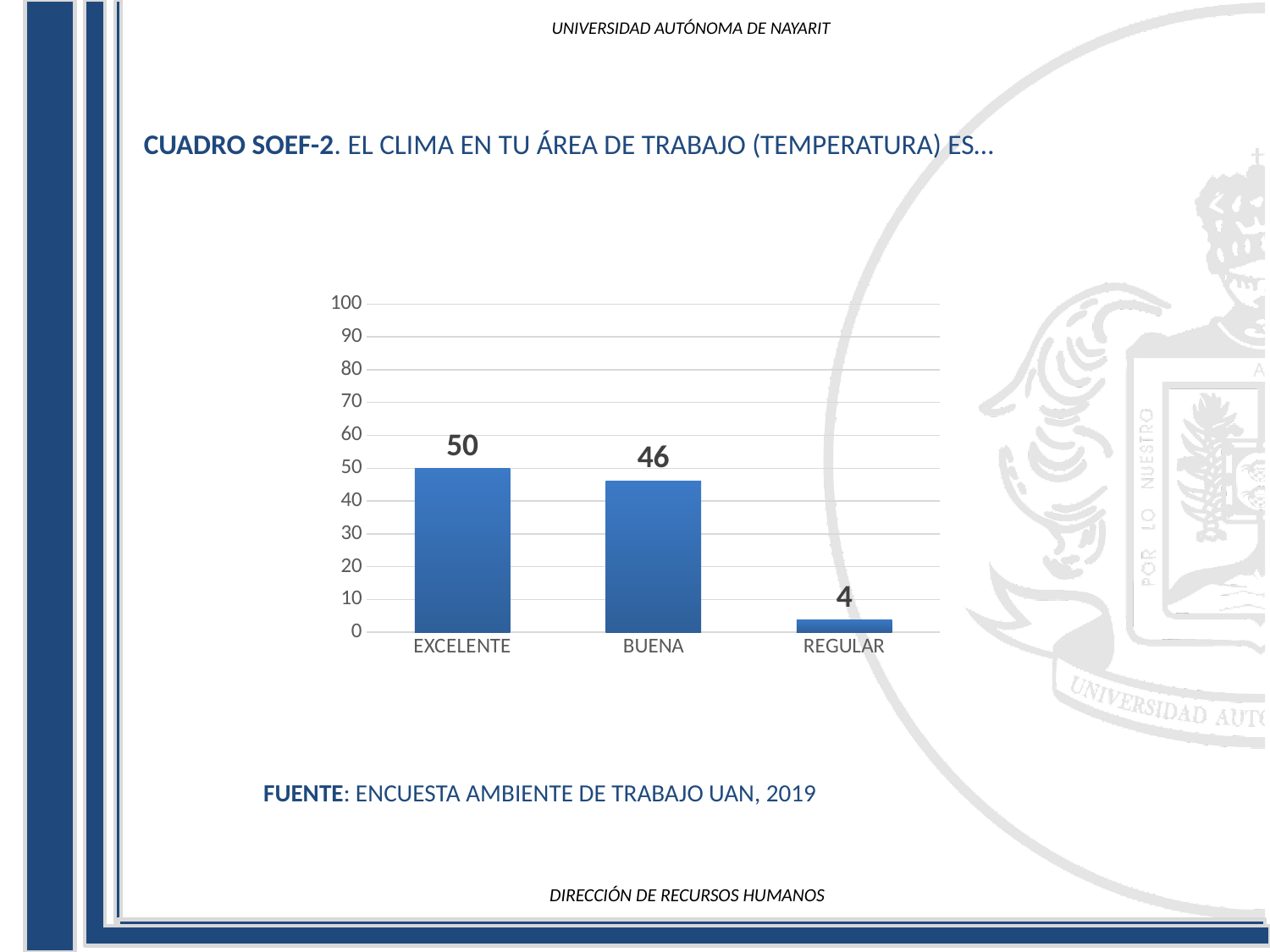
Is the value for EXCELENTE greater or less than 40? greater What is the difference between the values for BUENA and REGULAR? 42 What is the value for BUENA? 46 Which category has the highest value? EXCELENTE What is the difference between the values for EXCELENTE and BUENA? 4 Which category has the lowest value? REGULAR What is the value for REGULAR? 4 What kind of chart is shown on the slide? bar chart How many categories are shown on the x axis? 3 What is the value for EXCELENTE? 50 Which is larger, the value for BUENA or the value for REGULAR? BUENA Do the values rise or fall from left to right along the x axis? fall